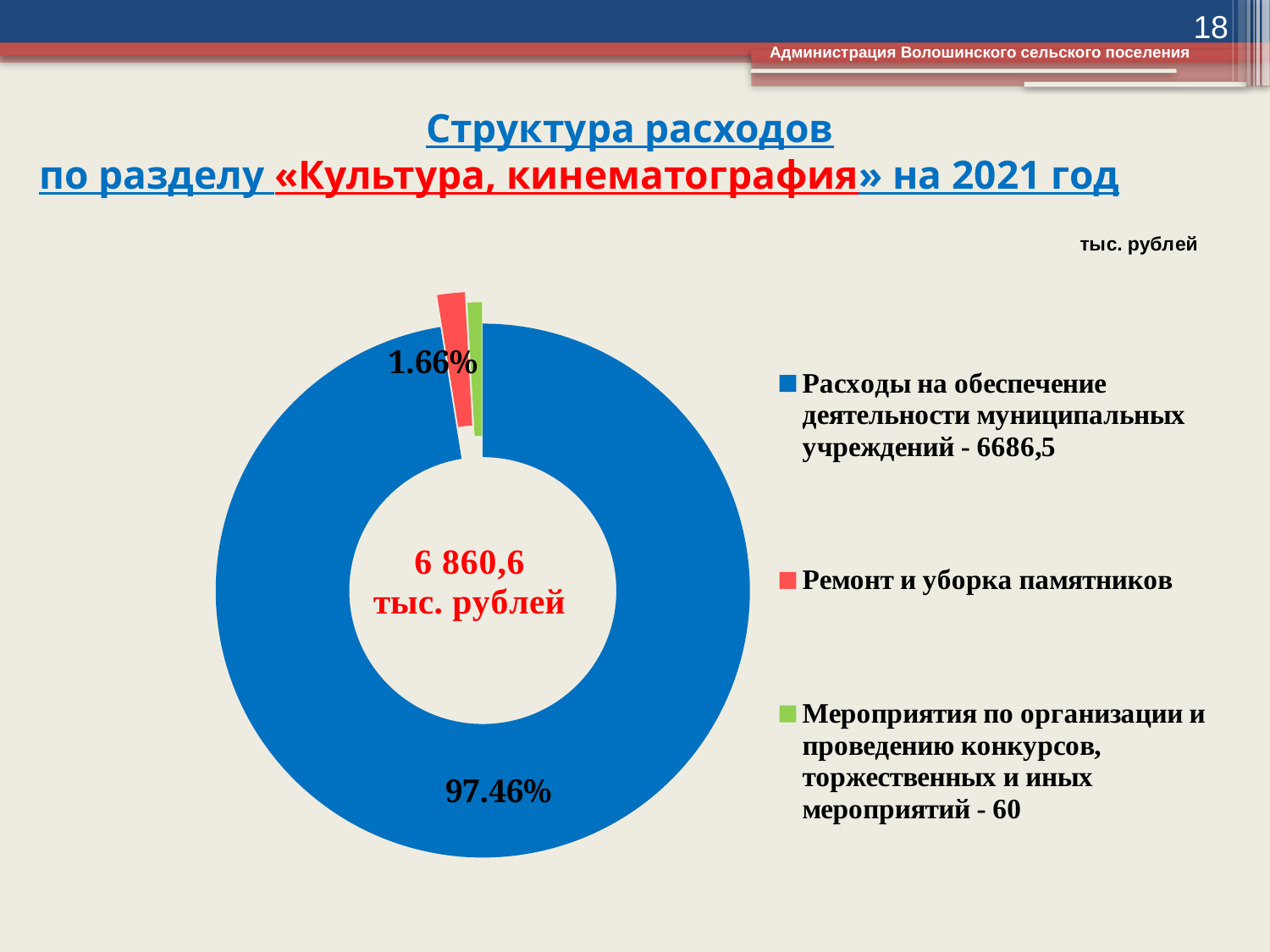
Which colour represents 'Ремонт и уборка памятников' in the chart? Red What percentage is shown for the slice 'Ремонт и уборка памятников'? 1.66% Which category has the largest share of the pie chart? Расходы на обеспечение деятельности муниципальных учреждений What total amount is shown in the centre of the doughnut chart? 6 860,6 тыс. рублей Which category has the smallest share of the pie chart? Мероприятия по организации и проведению конкурсов, торжественных и иных мероприятий What is the difference between the value for 'Расходы на обеспечение деятельности муниципальных учреждений' (6686,5) and the value for 'Мероприятия по организации и проведению конкурсов, торжественных и иных мероприятий' (60)? 6626,5 What value is given in the legend for 'Мероприятия по организации и проведению конкурсов, торжественных и иных мероприятий'? 60 What value is given in the legend for 'Расходы на обеспечение деятельности муниципальных учреждений'? 6686,5 How many entries does the legend list? 3 What kind of chart is shown on the slide? Pie chart (doughnut) What percentage share is shown for the largest slice of the pie chart? 97.46% How many slices does the pie chart have? 3